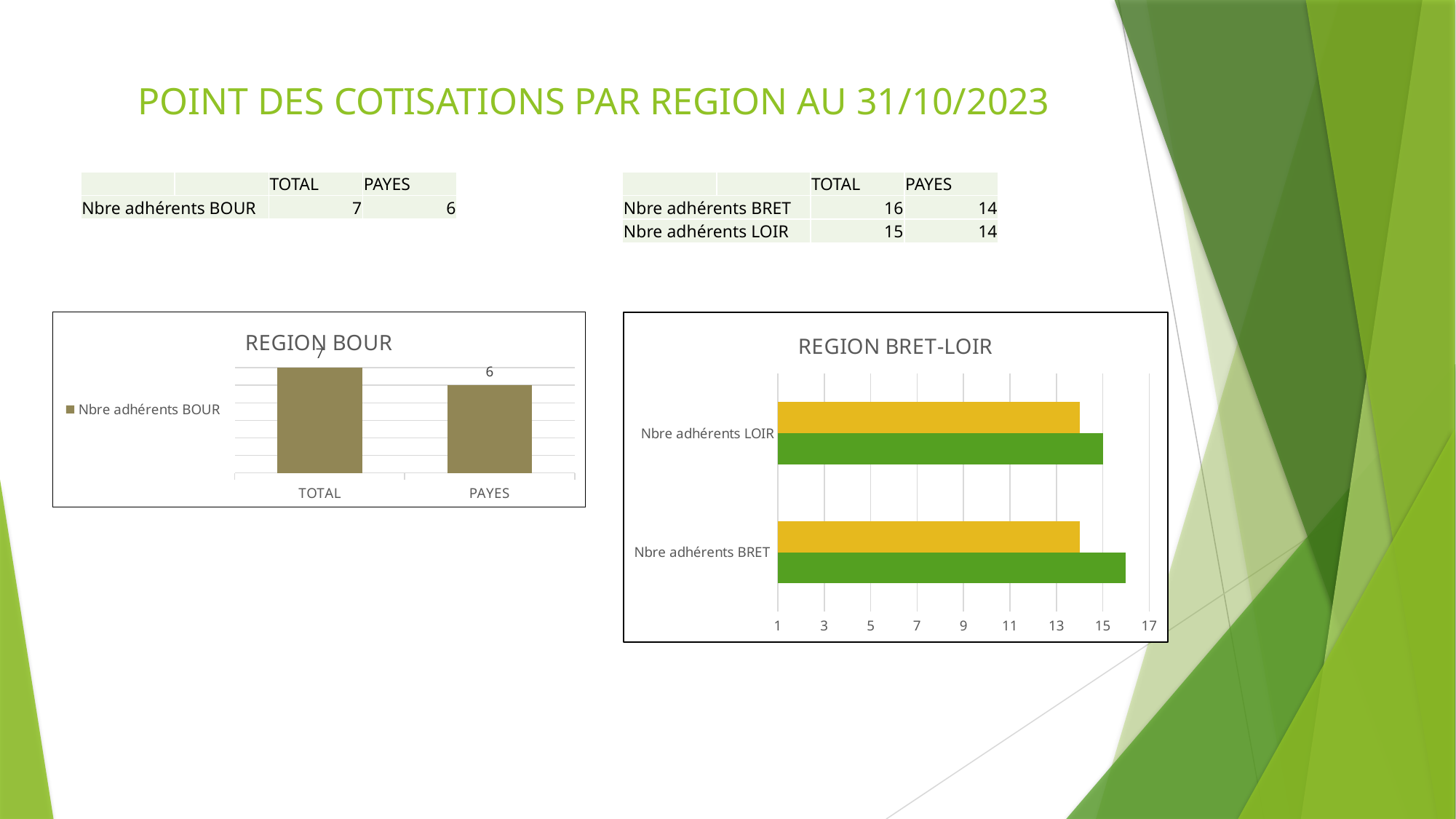
In the REGION BOUR chart, what series name does the legend show? Nbre adhérents BOUR In the REGION BRET-LOIR chart, which category has the longer green bar, Nbre adhérents BRET or Nbre adhérents LOIR? Nbre adhérents BRET In the REGION BOUR chart, how many categories are shown on the x axis? 2 What kind of chart is the REGION BRET-LOIR chart? Bar chart In the REGION BOUR chart, what is the difference between TOTAL and PAYES? 1 In the REGION BRET-LOIR chart, is the yellow bar for Nbre adhérents LOIR greater or less than 15? less What kind of chart is the REGION BOUR chart? Bar chart In the REGION BOUR chart, what is the value for TOTAL? 7 In the REGION BRET-LOIR chart, how many categories are listed on the vertical axis? 2 In the REGION BOUR chart, which category has the higher value? TOTAL In the REGION BRET-LOIR chart, is the green bar for Nbre adhérents BRET greater or less than 15? greater In the REGION BOUR chart, what is the value for PAYES? 6